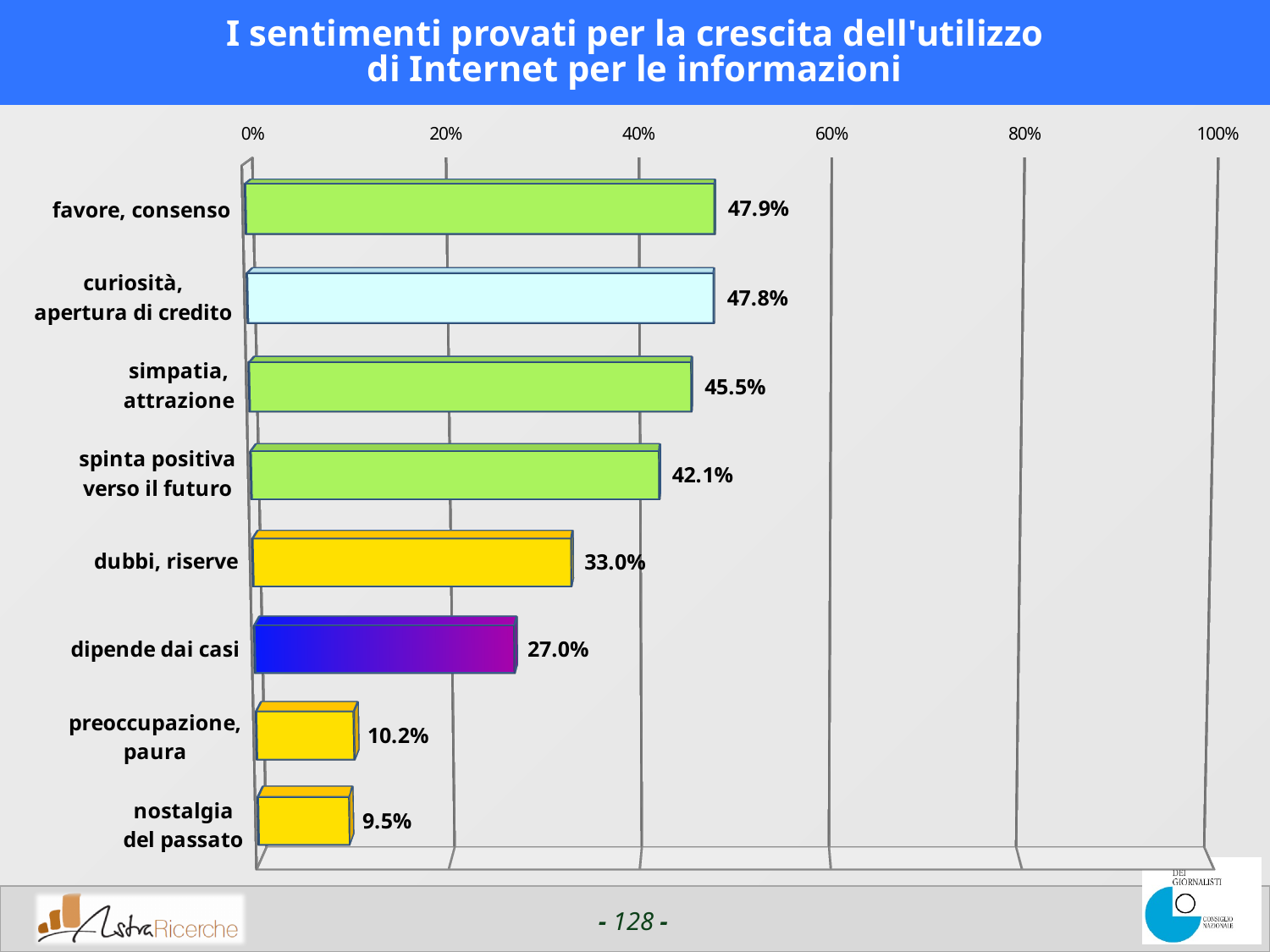
Which is larger, "spinta positiva verso il futuro" or "dubbi, riserve"? spinta positiva verso il futuro What is the difference between "simpatia, attrazione" and "spinta positiva verso il futuro"? 3.4% What is the value for "nostalgia del passato"? 9.5% What kind of chart is shown on the slide? bar chart What is the value for "dubbi, riserve"? 33.0% What is the difference between "dubbi, riserve" and "dipende dai casi"? 6.0% What is the title of the chart? I sentimenti provati per la crescita dell'utilizzo di Internet per le informazioni What is the value for "dipende dai casi"? 27.0% What is the value for "favore, consenso"? 47.9% Which is larger, "preoccupazione, paura" or "nostalgia del passato"? preoccupazione, paura Which category has the lowest value? nostalgia del passato How many categories are shown in the chart? 8